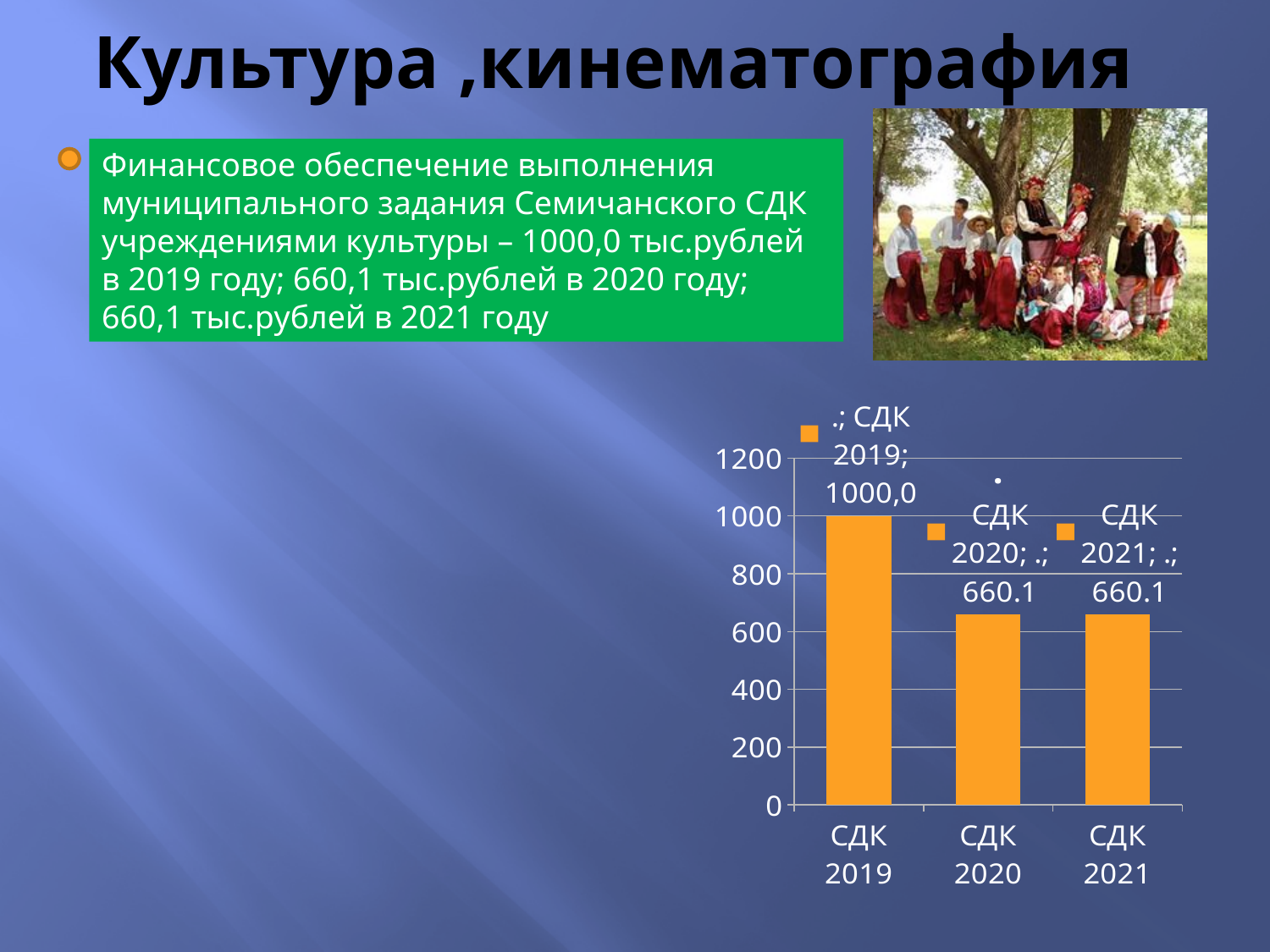
What is the value shown for СДК 2019? 1000,0 Do the values rise or fall from СДК 2019 to СДК 2021? fall Which category has the highest value in the chart? СДК 2019 How many bars are plotted in the chart? 3 What is the highest value shown on the vertical axis of the chart? 1200 Is the value for СДК 2019 greater or less than 800? greater What is the value shown for СДК 2021? 660.1 What colour are the bars in the chart? orange What type of chart is shown on the slide? bar chart Is the value for СДК 2020 greater or less than 800? less What is the value shown for СДК 2020? 660.1 Which is larger, the value for СДК 2019 or the value for СДК 2020? СДК 2019